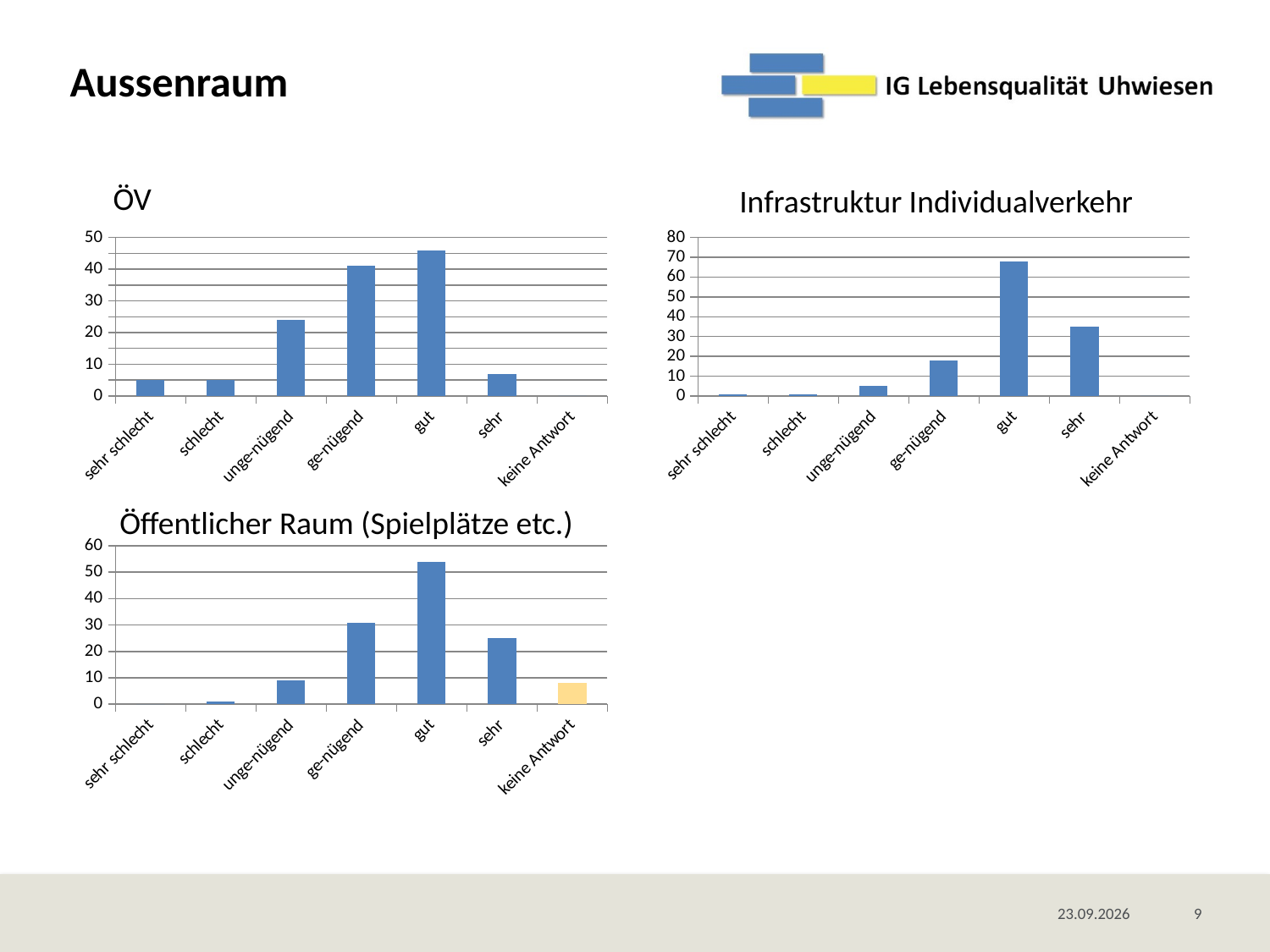
In the Infrastruktur Individualverkehr chart, is the value for gut greater or less than 60? greater In the ÖV chart, is the value for gut greater or less than 40? greater In the ÖV chart, which is larger, the value for ge-nügend or the value for unge-nügend? ge-nügend In the Infrastruktur Individualverkehr chart, is the value for ge-nügend greater or less than 10? greater In the ÖV chart, which category has the highest value? gut What kind of chart is the ÖV chart? bar chart In the Infrastruktur Individualverkehr chart, which is larger, the value for gut or the value for sehr? gut In the Öffentlicher Raum (Spielplätze etc.) chart, which category has the highest value? gut In the Infrastruktur Individualverkehr chart, which category has the highest value? gut How many categories are shown on the x axis of the Öffentlicher Raum (Spielplätze etc.) chart? 7